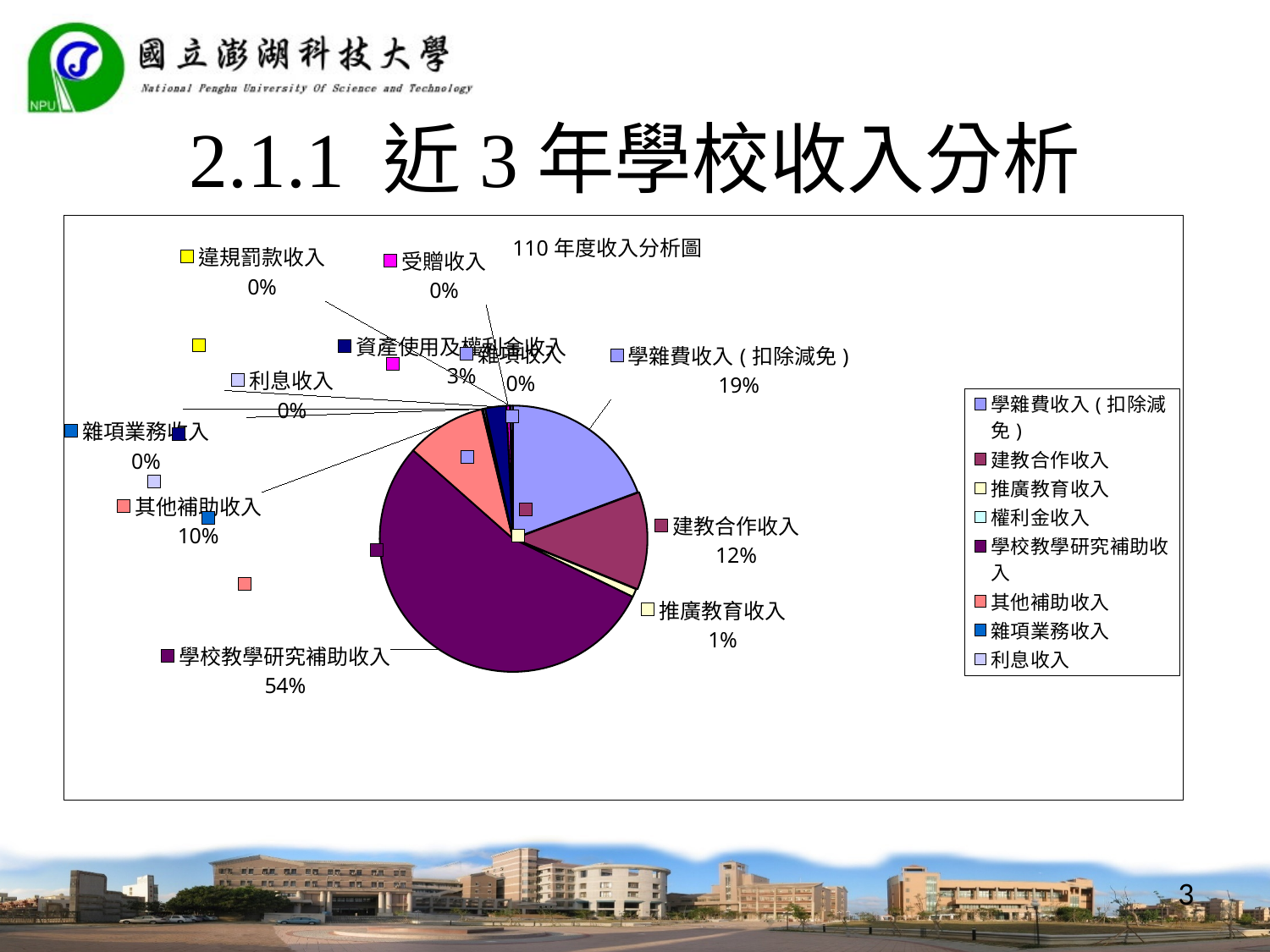
How many entries does the legend on the right list? 8 What is the difference in percentage points between 學校教學研究補助收入 and 學雜費收入（扣除減免）? 35% What percentage is shown for 推廣教育收入? 1% What percentage is shown for 資產使用及權利金收入? 3% What is the title of the chart? 110 年度收入分析圖 What percentage is shown for 其他補助收入? 10% What kind of chart is shown on the slide? pie chart What share of the pie does 學校教學研究補助收入 represent? 54% Which is larger, 建教合作收入 or 其他補助收入? 建教合作收入 What percentage is shown for 建教合作收入? 12% Which category has the largest share of the pie? 學校教學研究補助收入 What percentage is shown for 學雜費收入（扣除減免）? 19%